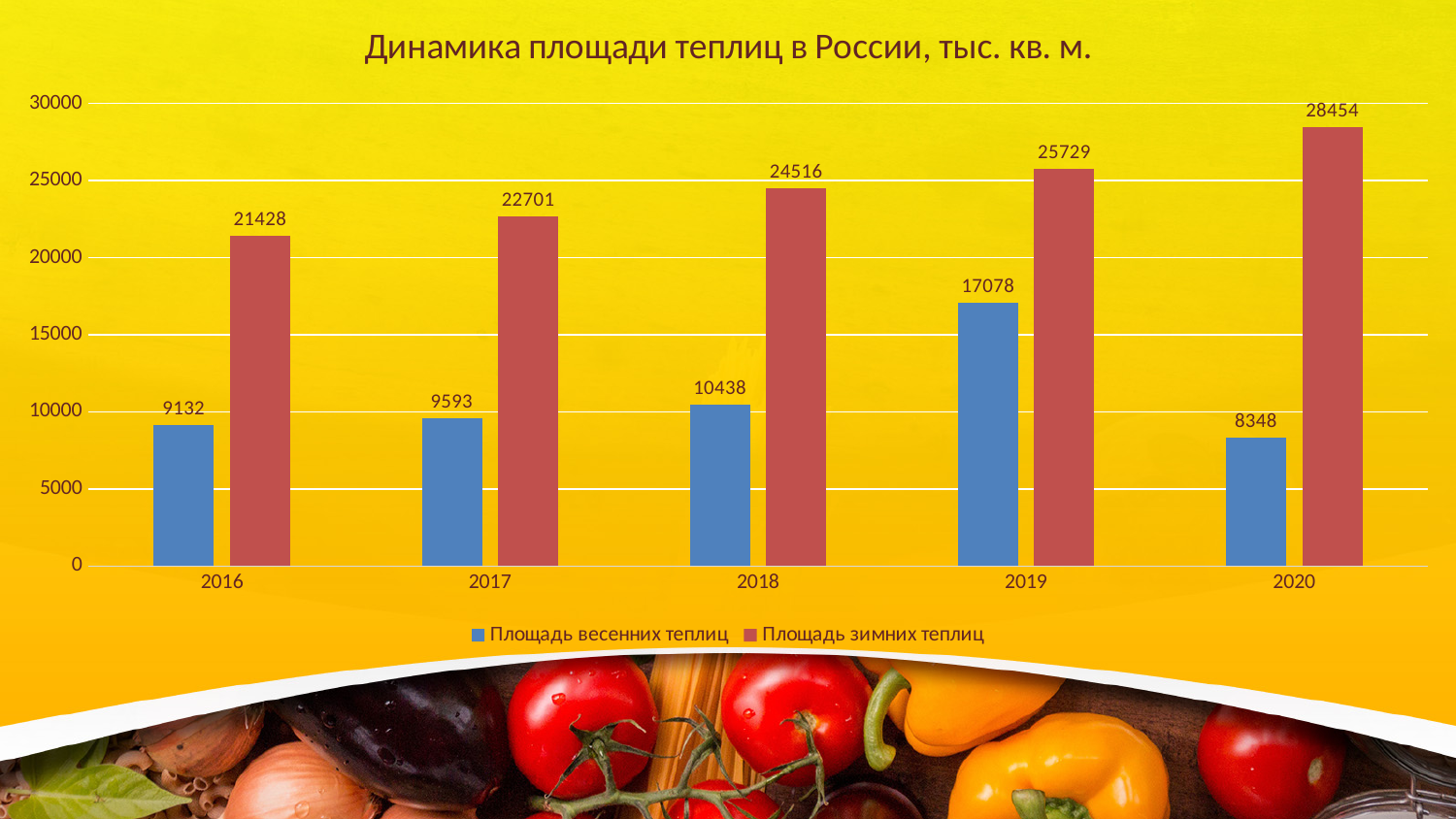
How many years are shown on the x axis? 5 What is the difference between Площадь зимних теплиц and Площадь весенних теплиц in 2016? 12296 What is the value for Площадь весенних теплиц in 2020? 8348 How many series does the legend list? 2 Is the value for Площадь зимних теплиц in 2019 greater or less than 25000? greater What is the value for Площадь зимних теплиц in 2018? 24516 Does Площадь зимних теплиц rise or fall from 2016 to 2020? rise What kind of chart is shown on the slide? bar chart Which is larger: Площадь весенних теплиц in 2018 or in 2017? 2018 In which year is Площадь зимних теплиц highest? 2020 In which year is Площадь весенних теплиц lowest? 2020 What is the value for Площадь весенних теплиц in 2019? 17078